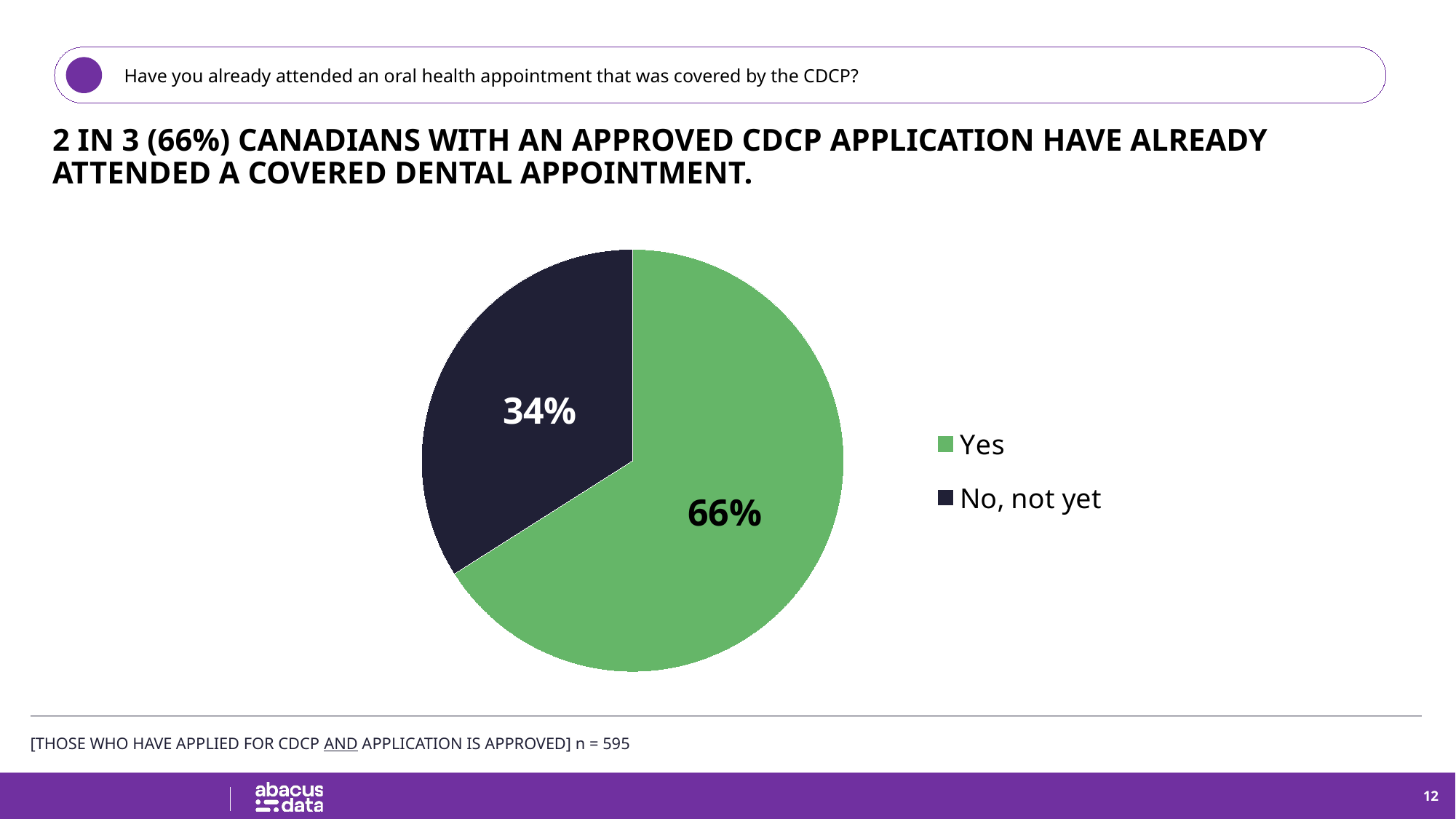
How many slices does the pie chart have? 2 What is the sample size (n) noted below the chart? 595 What kind of chart is shown on the slide? pie chart Which is larger, the "Yes" slice or the "No, not yet" slice? Yes What percentage of respondents answered "No, not yet"? 34% What is the difference in percentage points between the "Yes" and "No, not yet" slices? 32 Which response has the largest share of the pie? Yes Which response has the smallest share of the pie? No, not yet What colour is the "No, not yet" slice? dark navy What percentage of respondents answered "Yes"? 66% What share of the pie does the "Yes" slice represent? 66% How many entries does the legend list? 2